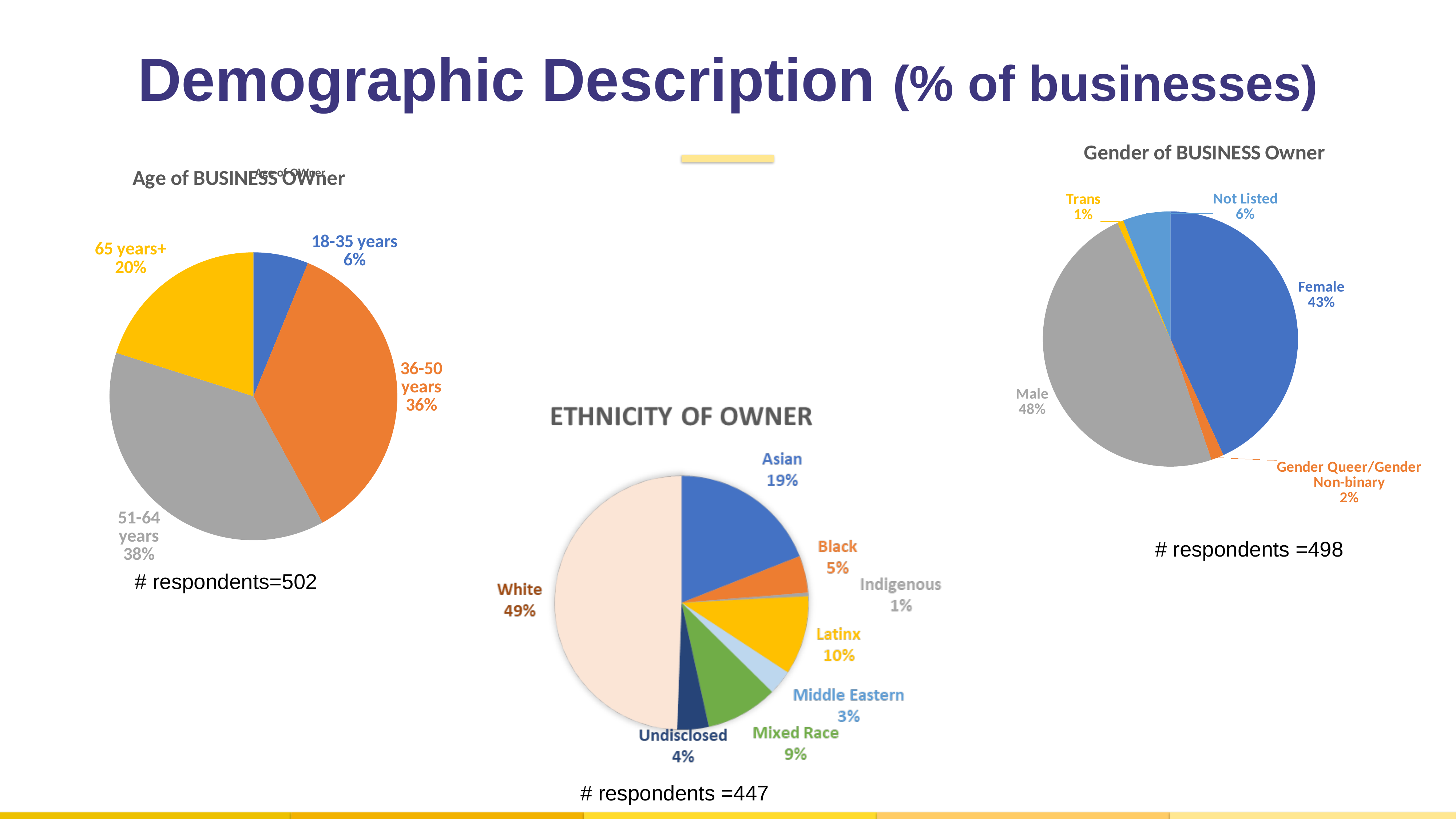
In the 'Age of BUSINESS Owner' pie chart, what percentage of owners are 51-64 years? 38% In the 'ETHNICITY OF OWNER' pie chart, what percentage of owners are Latinx? 10% In the 'Age of BUSINESS Owner' pie chart, which age group has the smallest share? 18-35 years What kind of chart is the 'Gender of BUSINESS Owner' chart? Pie chart In the 'ETHNICITY OF OWNER' pie chart, which is larger, the Asian share or the Mixed Race share? Asian In the 'Age of BUSINESS Owner' pie chart, what is the difference between the 36-50 years share and the 65 years+ share? 16% In the 'Gender of BUSINESS Owner' pie chart, what is the difference between the Male share and the Female share? 5% In the 'Gender of BUSINESS Owner' pie chart, what percentage of owners are Male? 48% In the 'Gender of BUSINESS Owner' pie chart, which category has the smallest share? Trans In the 'ETHNICITY OF OWNER' pie chart, which ethnicity has the largest share? White How many categories does the 'Age of BUSINESS Owner' pie chart show? 4 How many categories does the 'ETHNICITY OF OWNER' pie chart show? 8